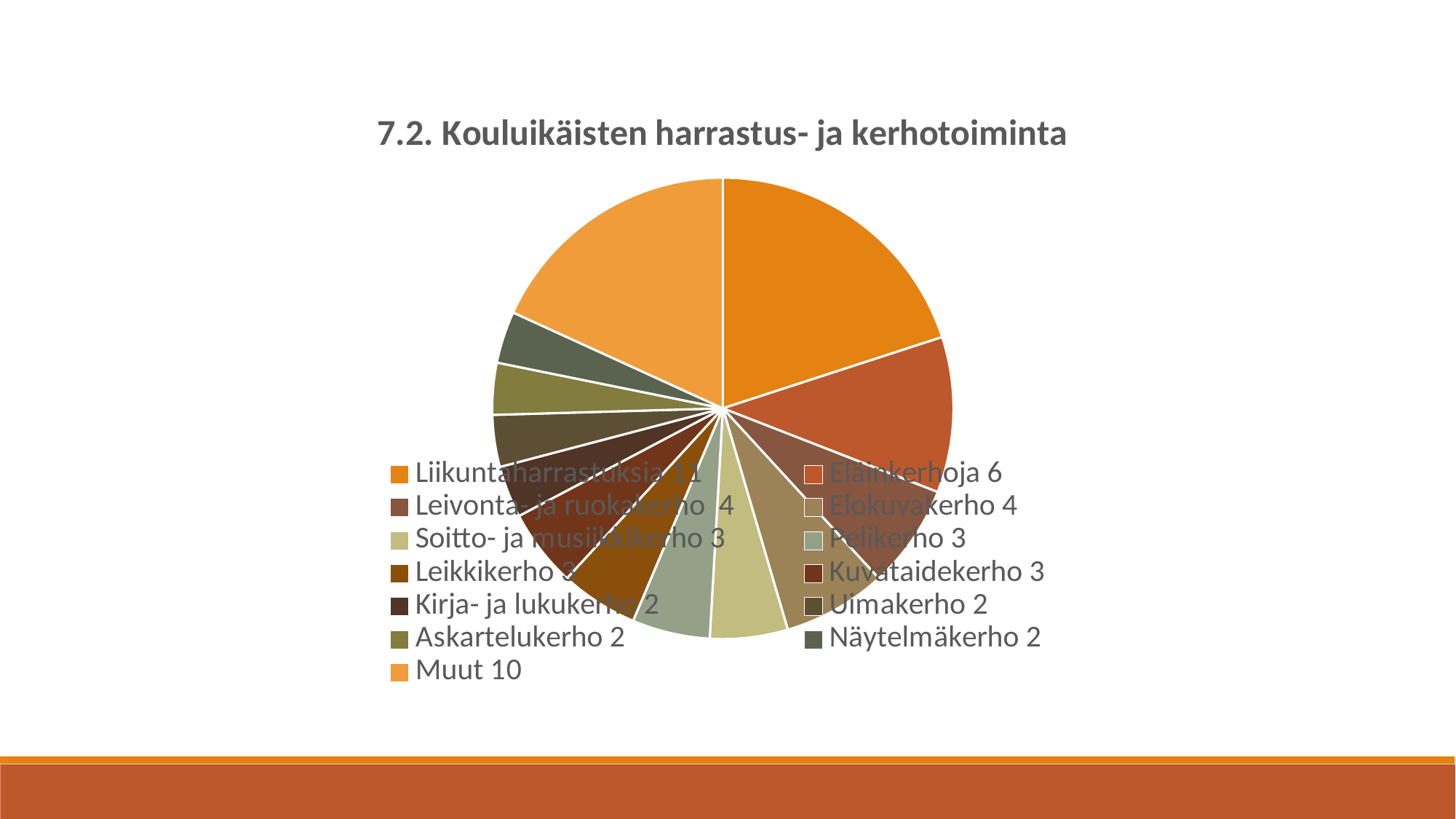
What is the value for Elokuvakerho? 4 What is the difference between the values for Eläinkerhoja and Uimakerho? 4 What kind of chart is shown on the slide? pie chart What is the value for Liikuntaharrastuksia? 11 What is the difference between the values for Liikuntaharrastuksia and Muut? 1 What is the value for Muut? 10 How many categories does the pie chart have? 13 Which category has the largest slice of the pie? Liikuntaharrastuksia Which is larger, the value for Eläinkerhoja or the value for Pelikerho? Eläinkerhoja What is the value for Eläinkerhoja? 6 What share of the pie does Liikuntaharrastuksia represent? 20% What is the title of the chart? 7.2. Kouluikäisten harrastus- ja kerhotoiminta